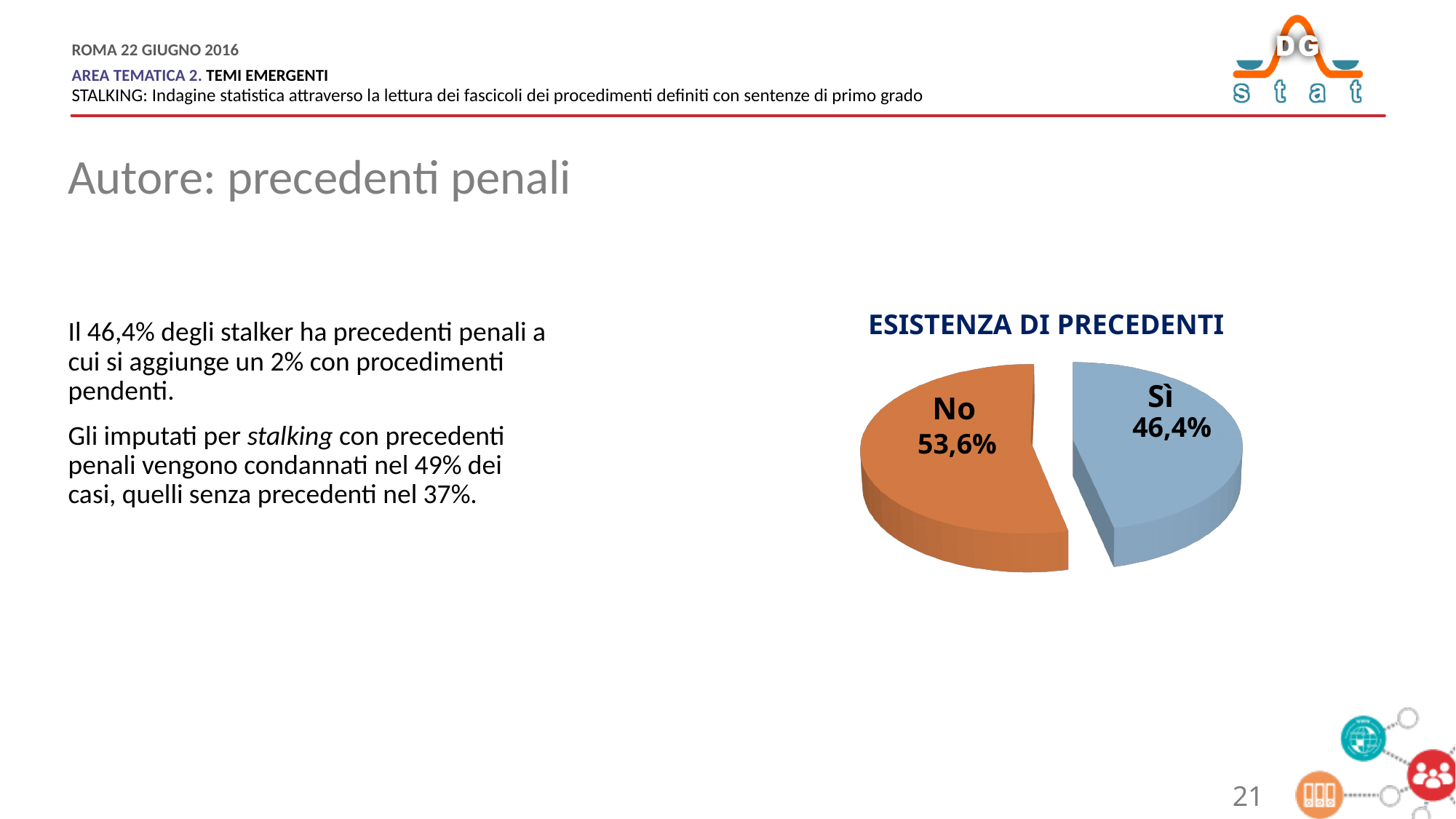
Which slice of the pie is the largest? No What share of the pie does the "No" slice represent? 53,6% How many slices does the pie chart have? 2 What is the difference in percentage points between the "No" and "Sì" slices? 7,2 Which slice of the pie is the smallest? Sì What is the title of the chart? ESISTENZA DI PRECEDENTI What share of the pie does the "Sì" slice represent? 46,4% What colour is the "Sì" slice of the pie? Blue Is the value for "Sì" greater or less than 50%? less What kind of chart is shown on the slide? Pie chart Which is larger, the "Sì" slice or the "No" slice? No